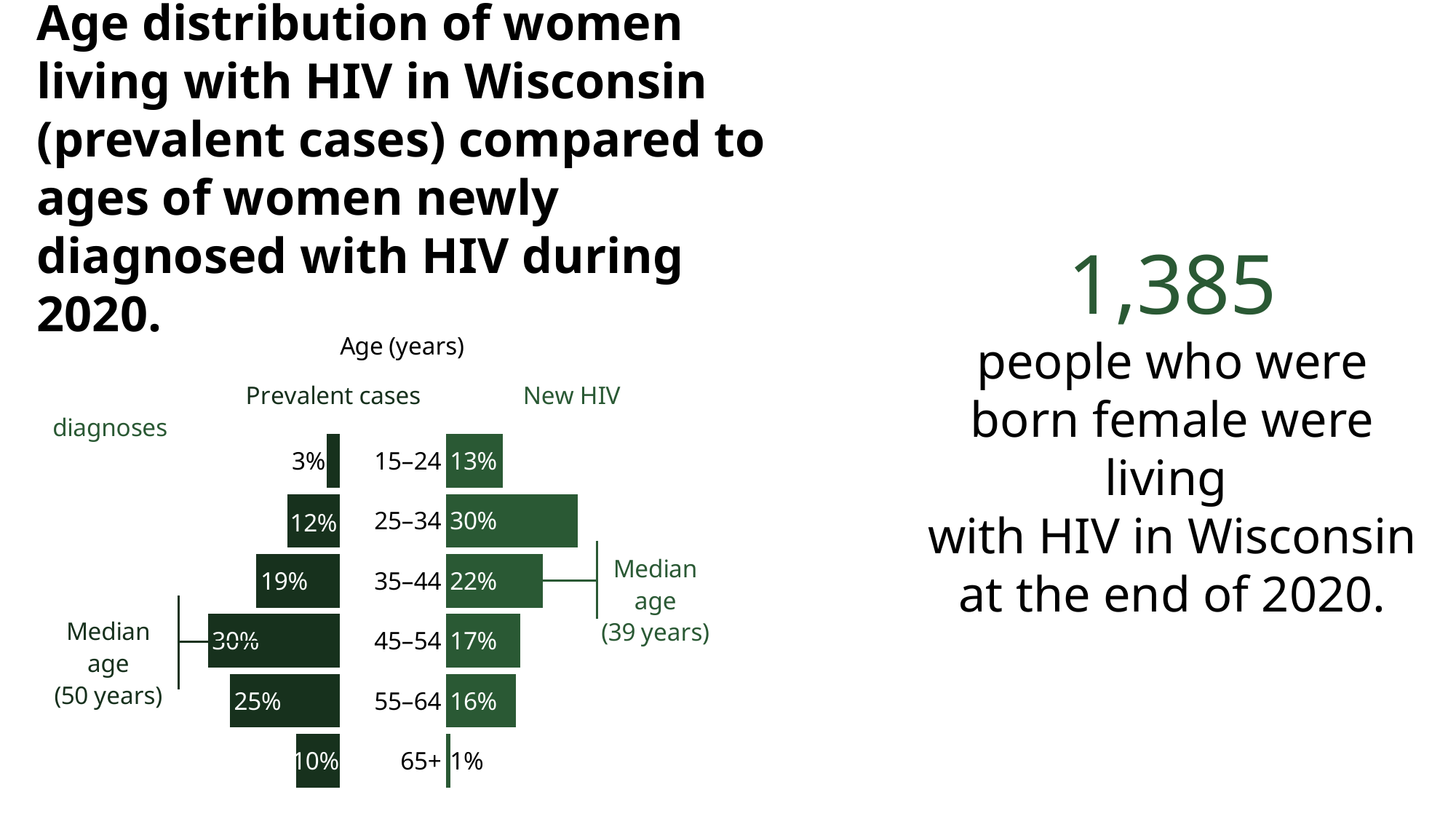
Which age group has the lowest share of new HIV diagnoses? 65+ What is the median age of women with prevalent HIV cases according to the chart? 50 years For the 35–44 age group, which is larger: the prevalent cases percentage or the new HIV diagnoses percentage? New HIV diagnoses What is the difference between the prevalent cases and new HIV diagnoses percentages for the 55–64 age group? 9% What kind of chart is shown on the slide? Bar chart What percentage of prevalent cases are in the 45–54 age group? 30% What percentage of prevalent cases are in the 15–24 age group? 3% How many age groups are shown in the chart? 6 Which age group has the highest share of prevalent cases? 45–54 What percentage of new HIV diagnoses are in the 25–34 age group? 30% What percentage of new HIV diagnoses are in the 65+ age group? 1% How many series does the chart show? 2